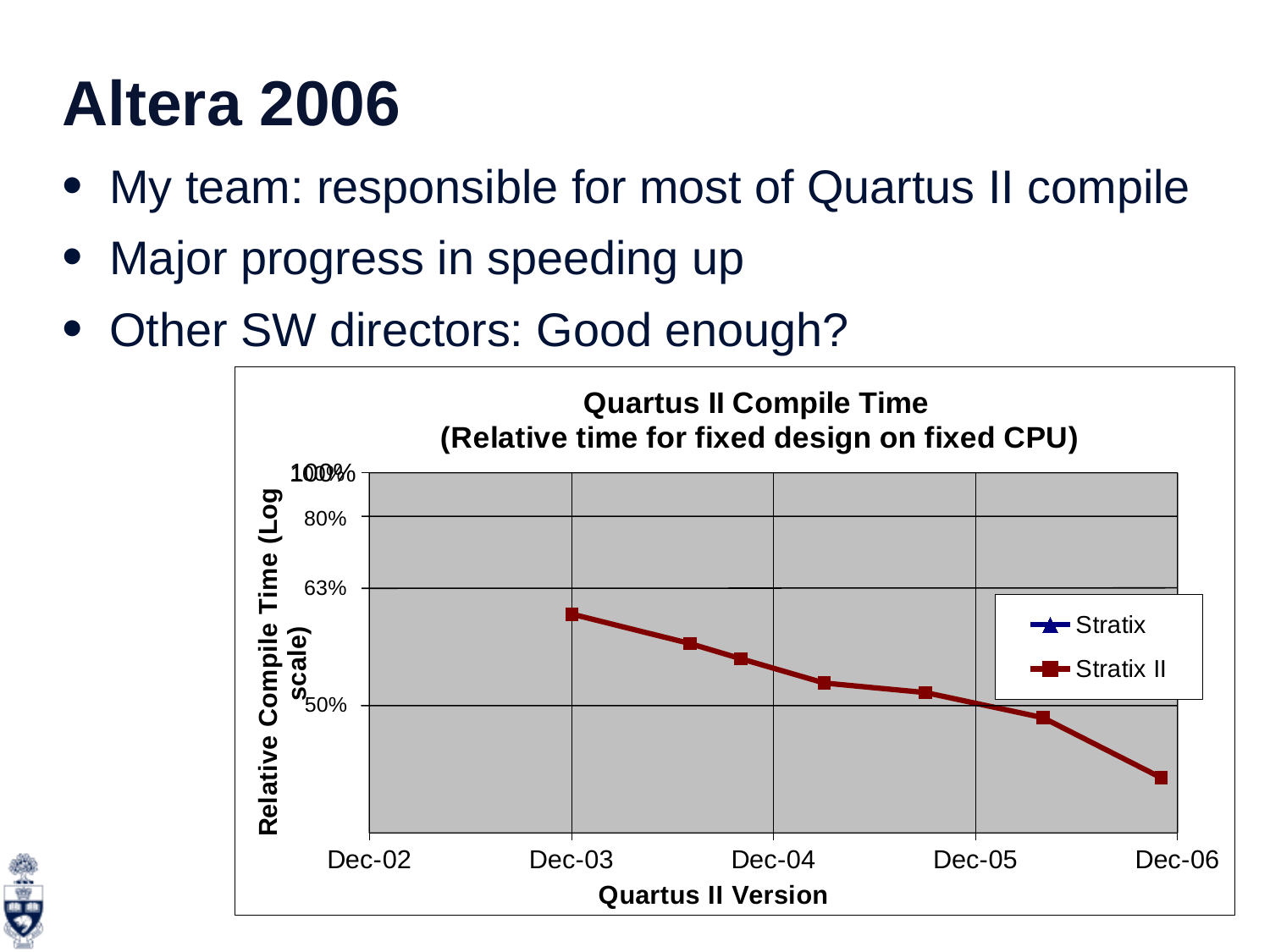
Which series is drawn with square markers? Stratix II What is the title of the chart? Quartus II Compile Time (Relative time for fixed design on fixed CPU) How many series does the legend list? 2 What kind of chart is shown on the slide? line chart Which is larger for Stratix II: the value near Dec-03 or the value near Dec-06? Dec-03 What is the label of the x axis? Quartus II Version How many data points are plotted on the Stratix II line? 7 Does the Stratix II line rise or fall from Dec-03 to Dec-06? fall Is the first plotted Stratix II value (near Dec-03) greater or less than 50%? greater Is the last plotted Stratix II value (near Dec-06) greater or less than 50%? less